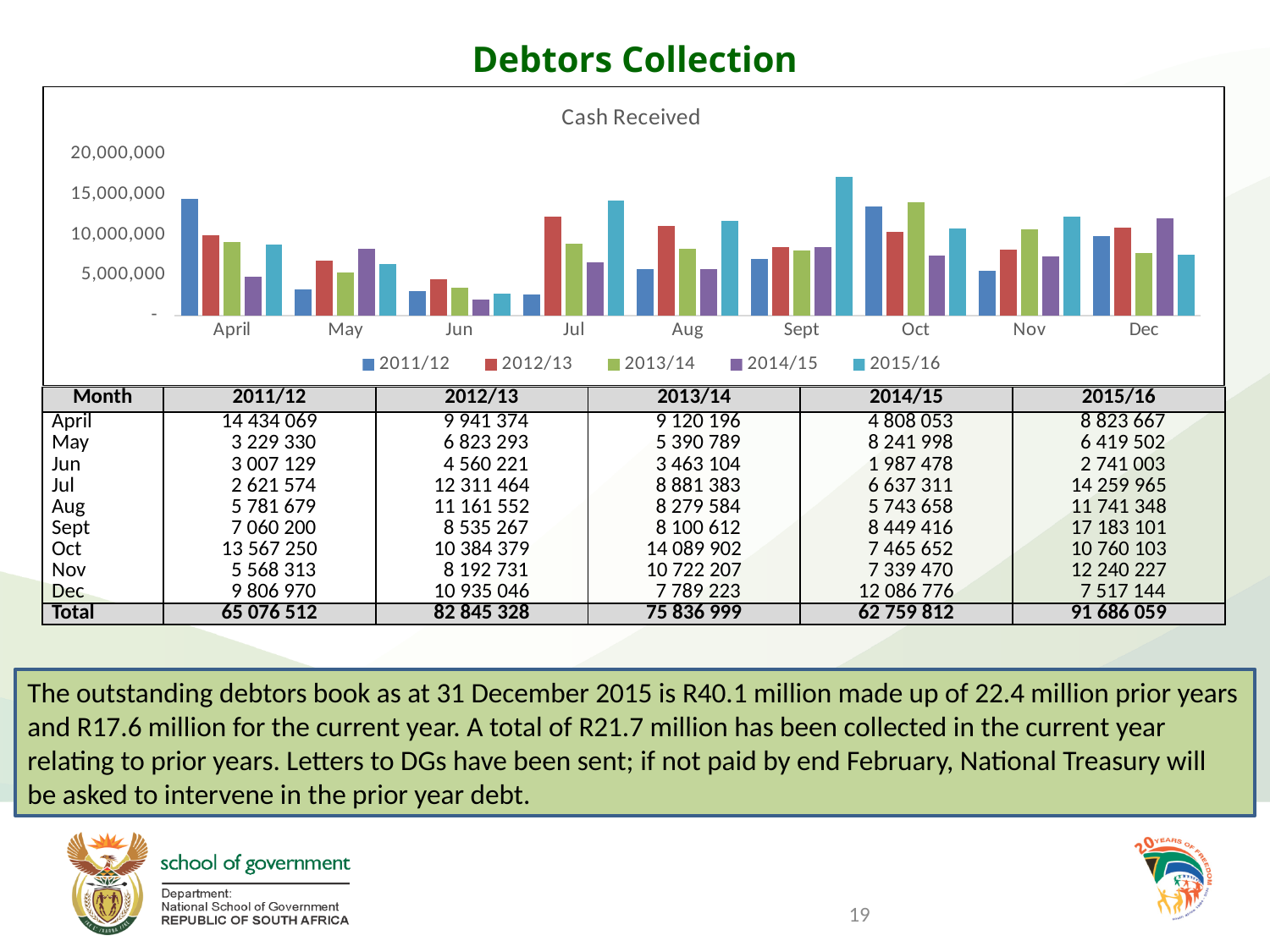
In which month is the 2015/16 cash received highest? Sept In which month is the 2011/12 cash received lowest? Jul What is the title of the chart? Cash Received Does the 2013/14 cash received rise or fall from Jul to Sept? fall What is the difference between the 2013/14 and 2014/15 cash received in Oct? 6 624 250 What is the cash received for 2015/16 in Sept? 17 183 101 What is the cash received for 2013/14 in Oct? 14 089 902 How many months are shown on the x axis of the Cash Received chart? 9 What kind of chart is shown on the slide? bar chart Is the value for 2015/16 in Sept greater or less than 15,000,000? greater In April, which series has the larger cash received, 2011/12 or 2012/13? 2011/12 How many series does the legend of the Cash Received chart list? 5